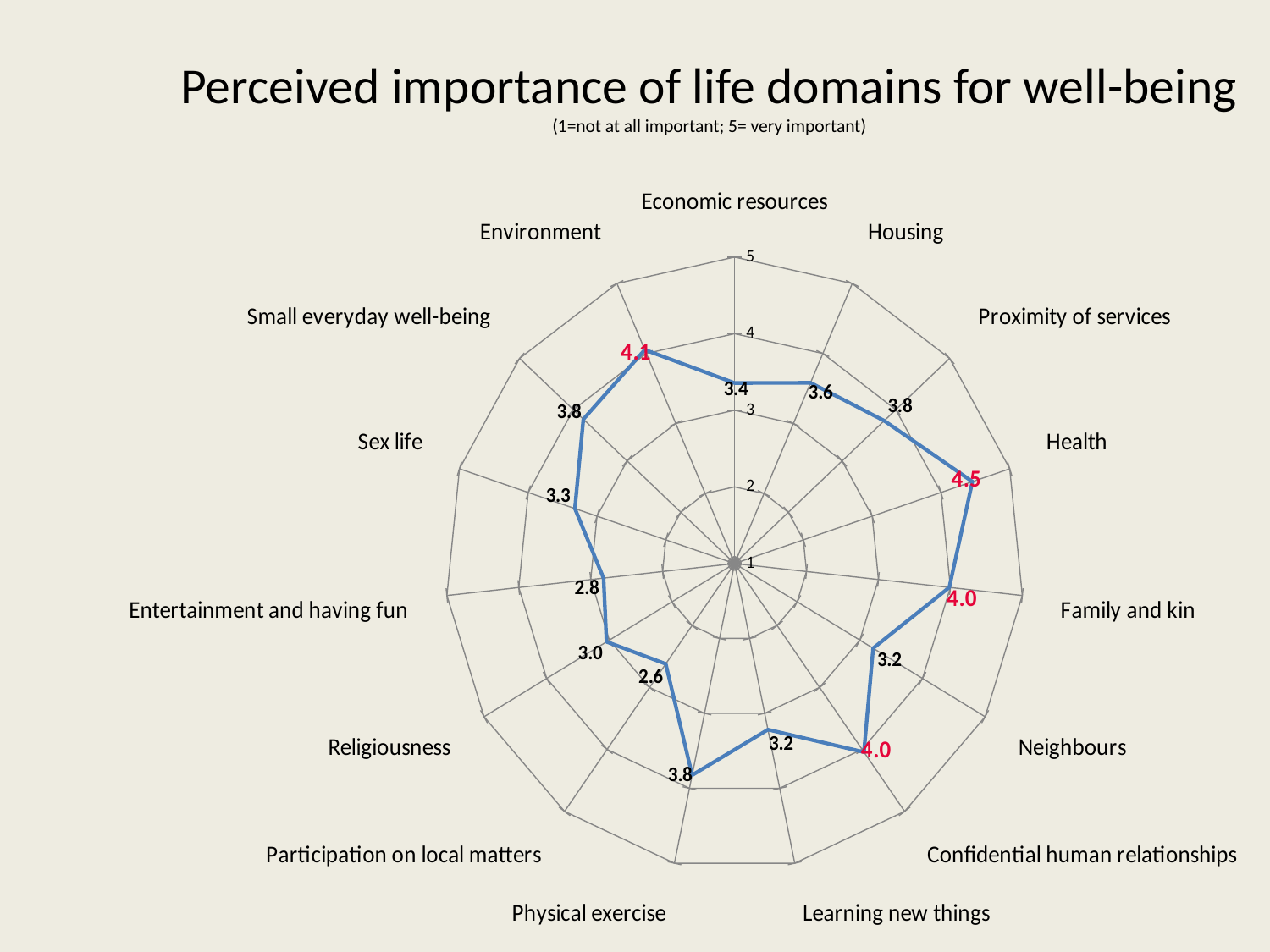
Which life domain has the highest perceived importance? Health How many life domains are plotted on the chart? 15 Which has a higher value, Housing or Proximity of services? Proximity of services What is the title of the chart? Perceived importance of life domains for well-being Is the value for Religiousness greater or less than 4? less What is the difference between the values for Health and Economic resources? 1.1 What is the value for Environment? 4.1 What is the value for Participation on local matters? 2.6 What is the perceived importance value for Health? 4.5 What is the value for Economic resources? 3.4 What type of chart is shown on the slide? radar chart Which life domain has the lowest perceived importance? Participation on local matters